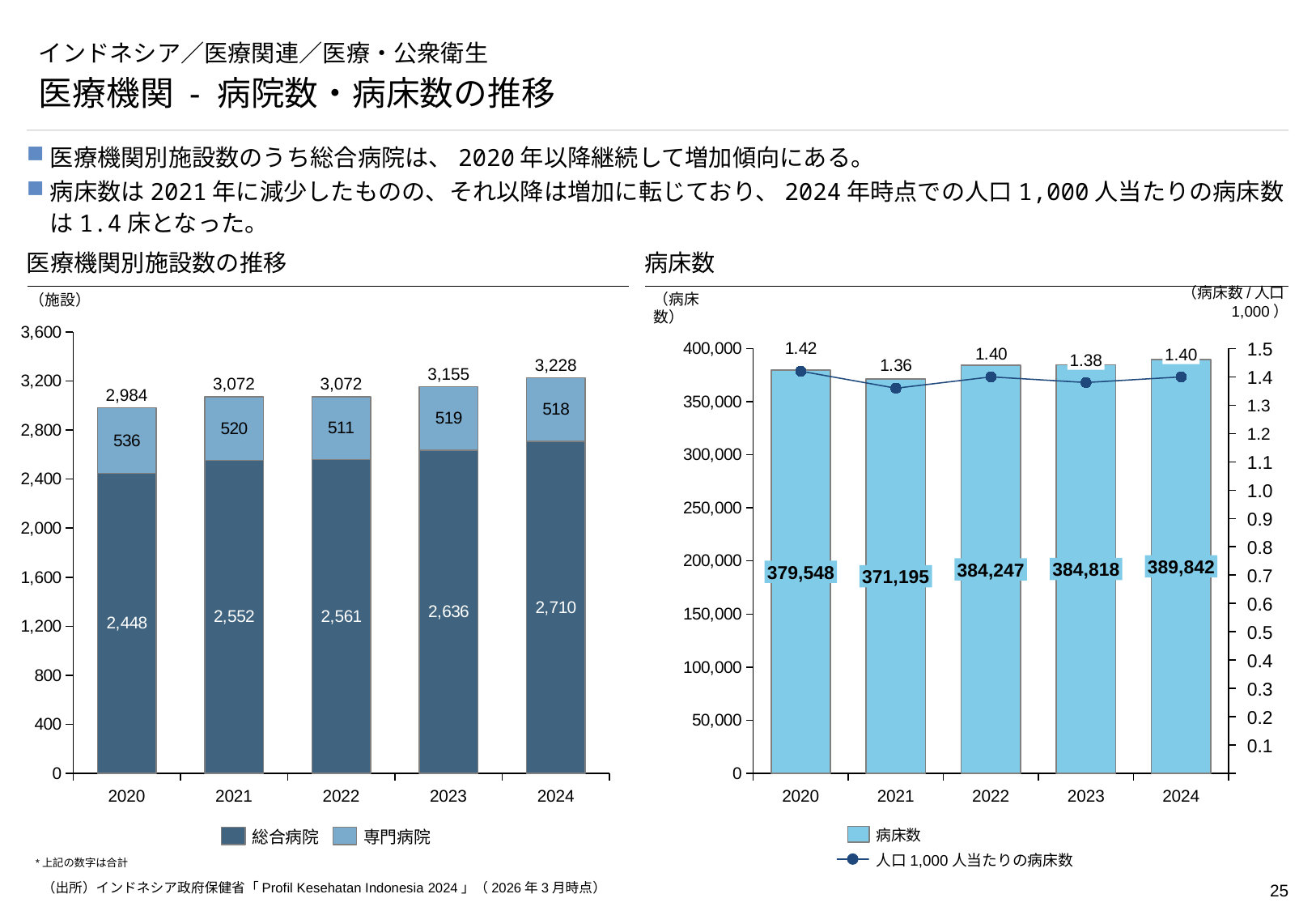
In the 医療機関別施設数の推移 chart, do the 総合病院 values rise or fall from 2020 to 2024? rise In the 病床数 chart, what is the 病床数 value for 2021? 371,195 In the 病床数 chart, how many years are shown on the x axis? 5 In the 医療機関別施設数の推移 chart, what is the value for 専門病院 in 2020? 536 In the 医療機関別施設数の推移 chart, how many series does the legend list? 2 In the 医療機関別施設数の推移 chart, what is the total of the stacked bar for 2023? 3,155 In the 医療機関別施設数の推移 chart, what is the difference between the 総合病院 values for 2024 and 2020? 262 In the 医療機関別施設数の推移 chart, what is the value for 総合病院 in 2024? 2,710 In the 医療機関別施設数の推移 chart, which year has the lowest value for 専門病院? 2022 In the 病床数 chart, what is the 人口1,000人当たりの病床数 value for 2023? 1.38 In the 病床数 chart, is the 病床数 for 2022 larger or smaller than for 2021? larger In the 病床数 chart, which year has the highest 病床数? 2024